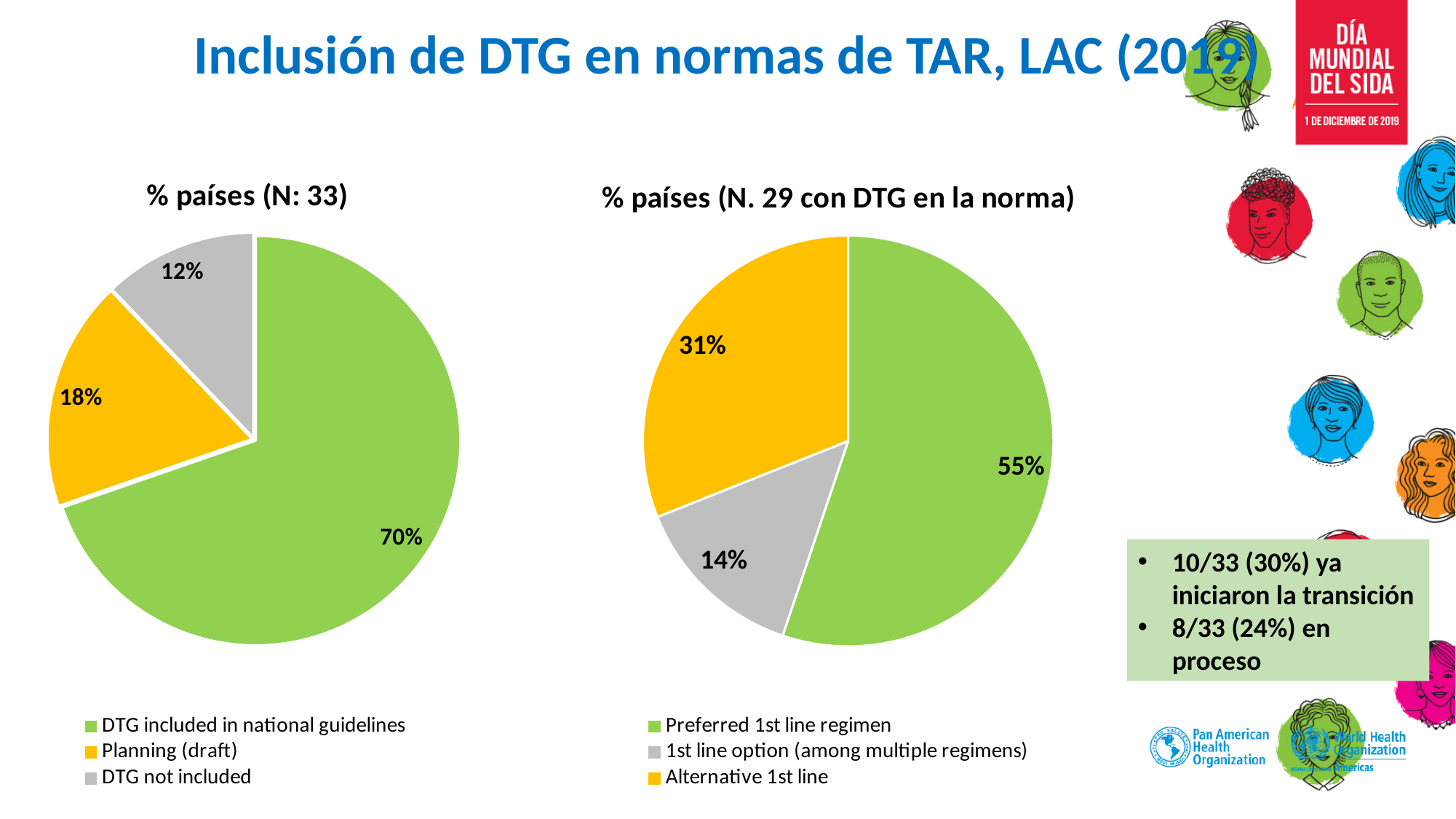
In the right chart titled '% países (N. 29 con DTG en la norma)', which category has the largest share? Preferred 1st line regimen In the right chart titled '% países (N. 29 con DTG en la norma)', what percentage corresponds to '1st line option (among multiple regimens)'? 14% What type of chart is the left chart titled '% países (N: 33)'? Pie chart In the left chart titled '% países (N: 33)', what percentage corresponds to 'Planning (draft)'? 18% In the right chart titled '% países (N. 29 con DTG en la norma)', what percentage corresponds to 'Alternative 1st line'? 31% In the left chart titled '% países (N: 33)', what percentage corresponds to 'DTG not included'? 12% In the right chart titled '% países (N. 29 con DTG en la norma)', which is larger: 'Alternative 1st line' or '1st line option (among multiple regimens)'? Alternative 1st line In the left chart titled '% países (N: 33)', what is the difference in percentage points between 'DTG included in national guidelines' and 'Planning (draft)'? 52 In the left chart titled '% países (N: 33)', which category has the smallest share? DTG not included In the left chart titled '% países (N: 33)', what percentage of countries have DTG included in national guidelines? 70% In the right chart titled '% países (N. 29 con DTG en la norma)', what percentage corresponds to 'Preferred 1st line regimen'? 55% How many categories does the legend of the right chart titled '% países (N. 29 con DTG en la norma)' list? 3